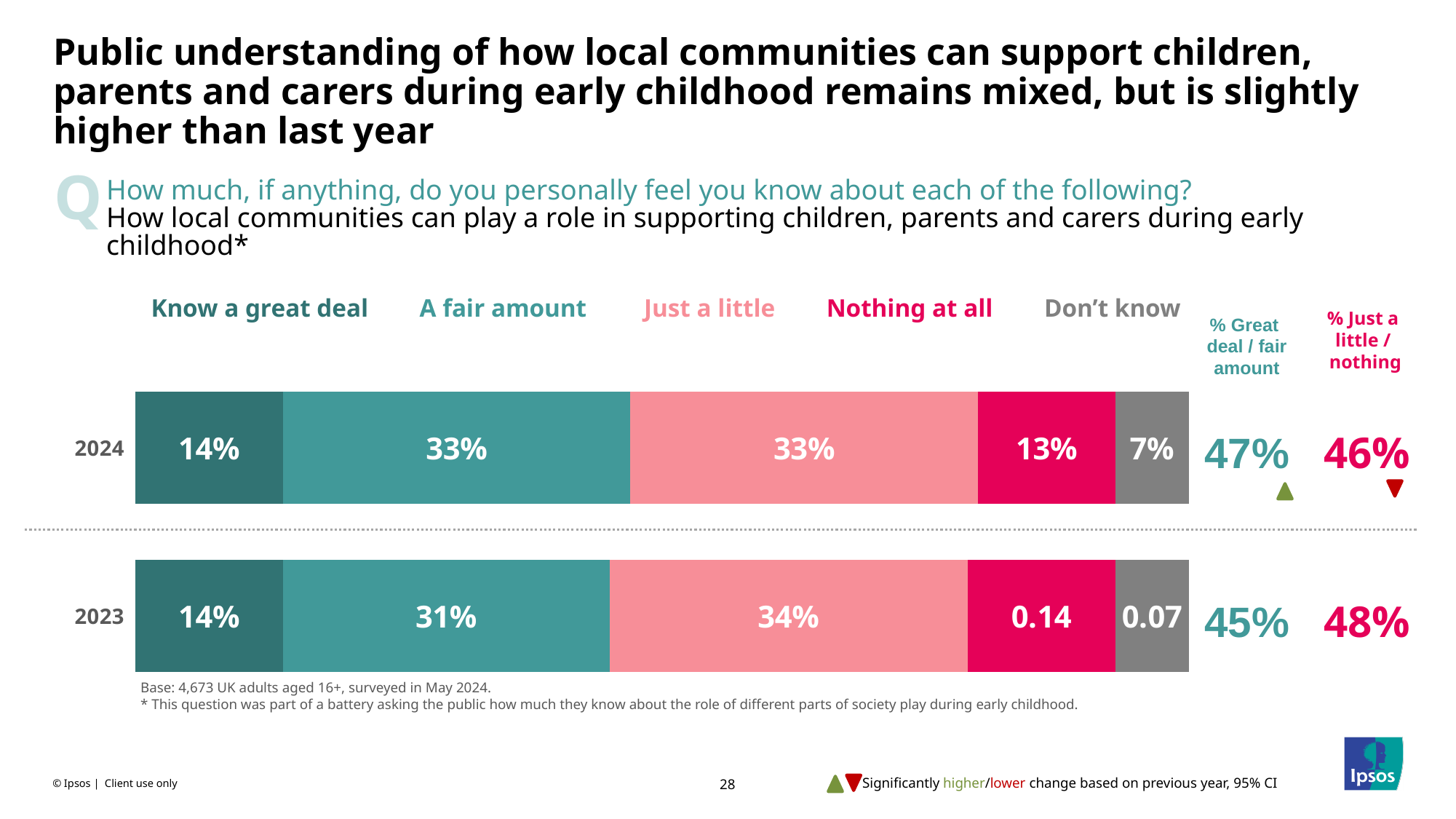
How many series does the legend list? 5 How many years (bars) are shown in the chart? 2 What kind of chart is shown on the slide? Stacked bar chart What is the 'Nothing at all' value for 2024? 13% What percentage of respondents in 2024 said they know a great deal? 14% What is the 'Just a little' value for 2024? 33% What is the 'Don't know' value shown for 2023? 0.07 Which is larger: the 'A fair amount' value for 2024 or for 2023? 2024 What is the combined '% Just a little / nothing' figure for 2023? 48% What is the difference between the 'A fair amount' values for 2024 and 2023? 2 percentage points What is the combined '% Great deal / fair amount' figure for 2024? 47% What percentage of respondents in 2023 said they know a fair amount? 31%